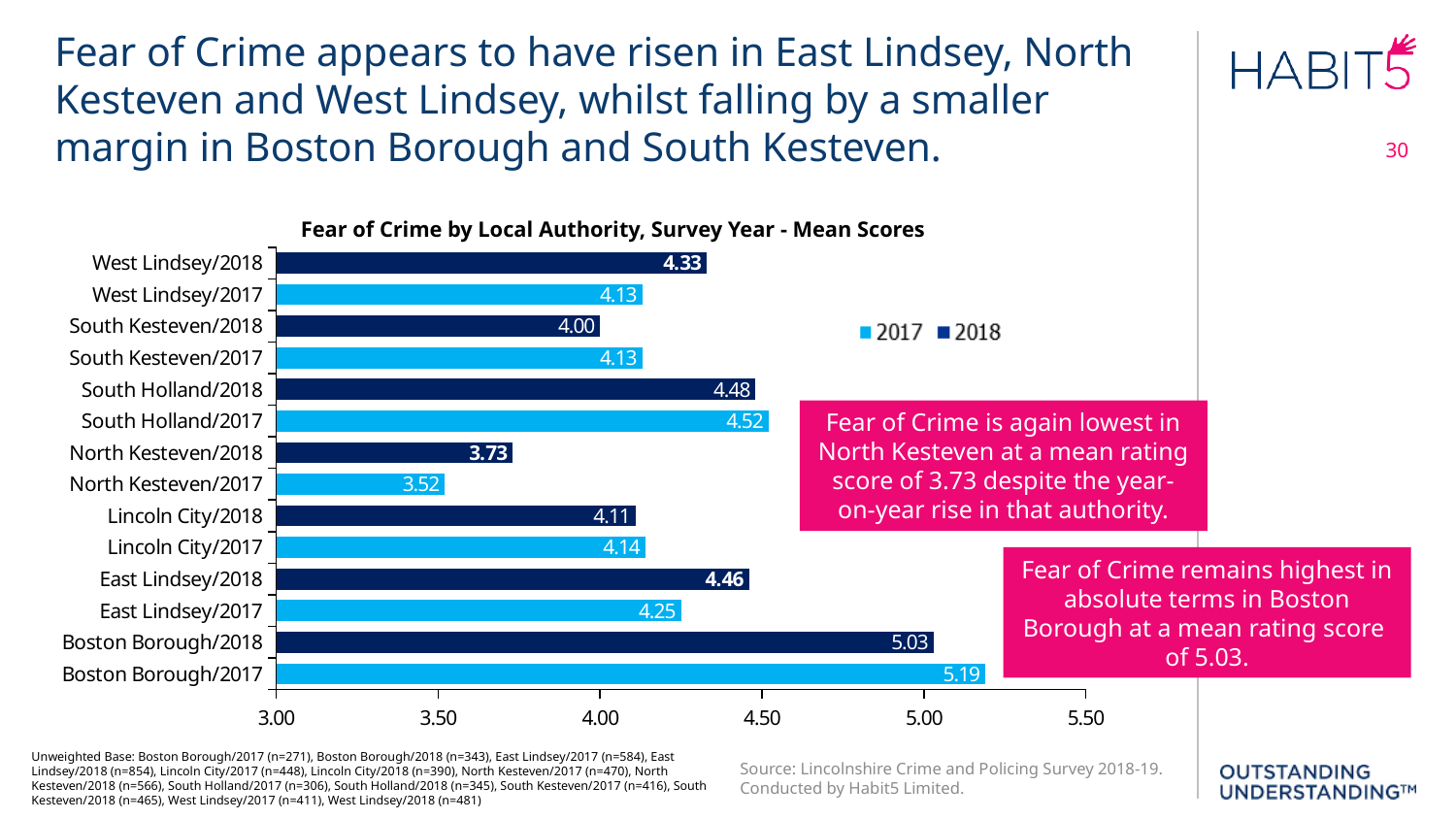
What is the mean score for Boston Borough/2018? 5.03 Is the value for South Kesteven/2018 greater or less than 4.50? less Which is larger, the mean score for West Lindsey/2018 or West Lindsey/2017? West Lindsey/2018 What is the mean score for South Holland/2017? 4.52 How many series does the legend list? 2 How many bars are plotted in the chart? 14 What kind of chart is shown on the slide? Bar chart What is the difference between the mean scores for Boston Borough/2017 and Boston Borough/2018? 0.16 What is the difference between the mean scores for East Lindsey/2018 and East Lindsey/2017? 0.21 What is the mean score for North Kesteven/2017? 3.52 Which category has the lowest mean score? North Kesteven/2017 Which category has the highest mean score? Boston Borough/2017